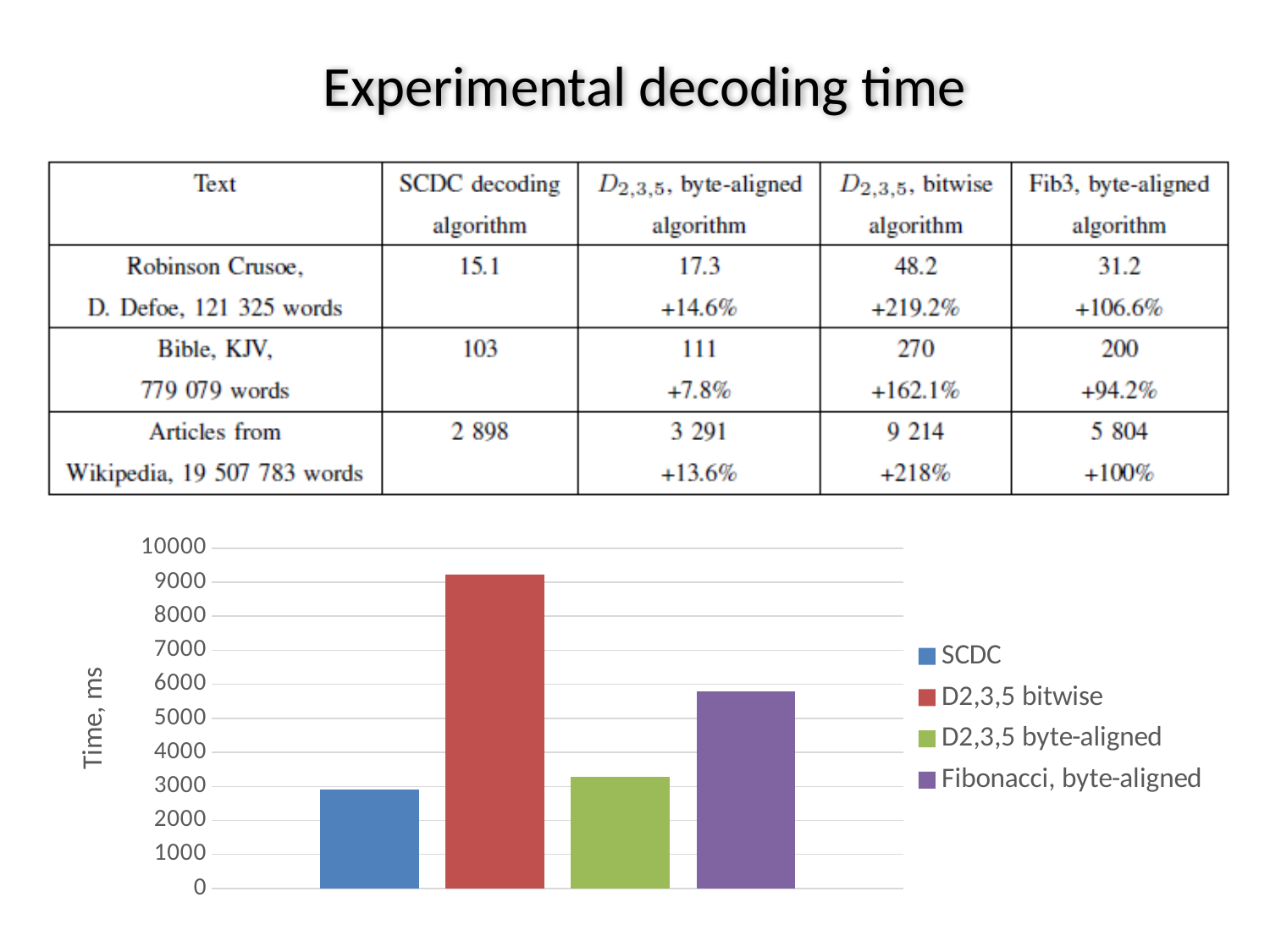
What kind of chart is shown on the slide? bar chart How many series does the chart legend list? 4 Which series has the lowest decoding time in the chart? SCDC Is the value for D2,3,5 bitwise greater or less than 9000? greater Which is larger in the chart: the value for Fibonacci, byte-aligned or the value for D2,3,5 byte-aligned? Fibonacci, byte-aligned What is the label on the vertical axis of the chart? Time, ms Is the value for D2,3,5 byte-aligned greater or less than 4000? less Is the value for Fibonacci, byte-aligned greater or less than 5000? greater Which series has the highest decoding time in the chart? D2,3,5 bitwise Which is larger in the chart: the value for D2,3,5 bitwise or the value for Fibonacci, byte-aligned? D2,3,5 bitwise